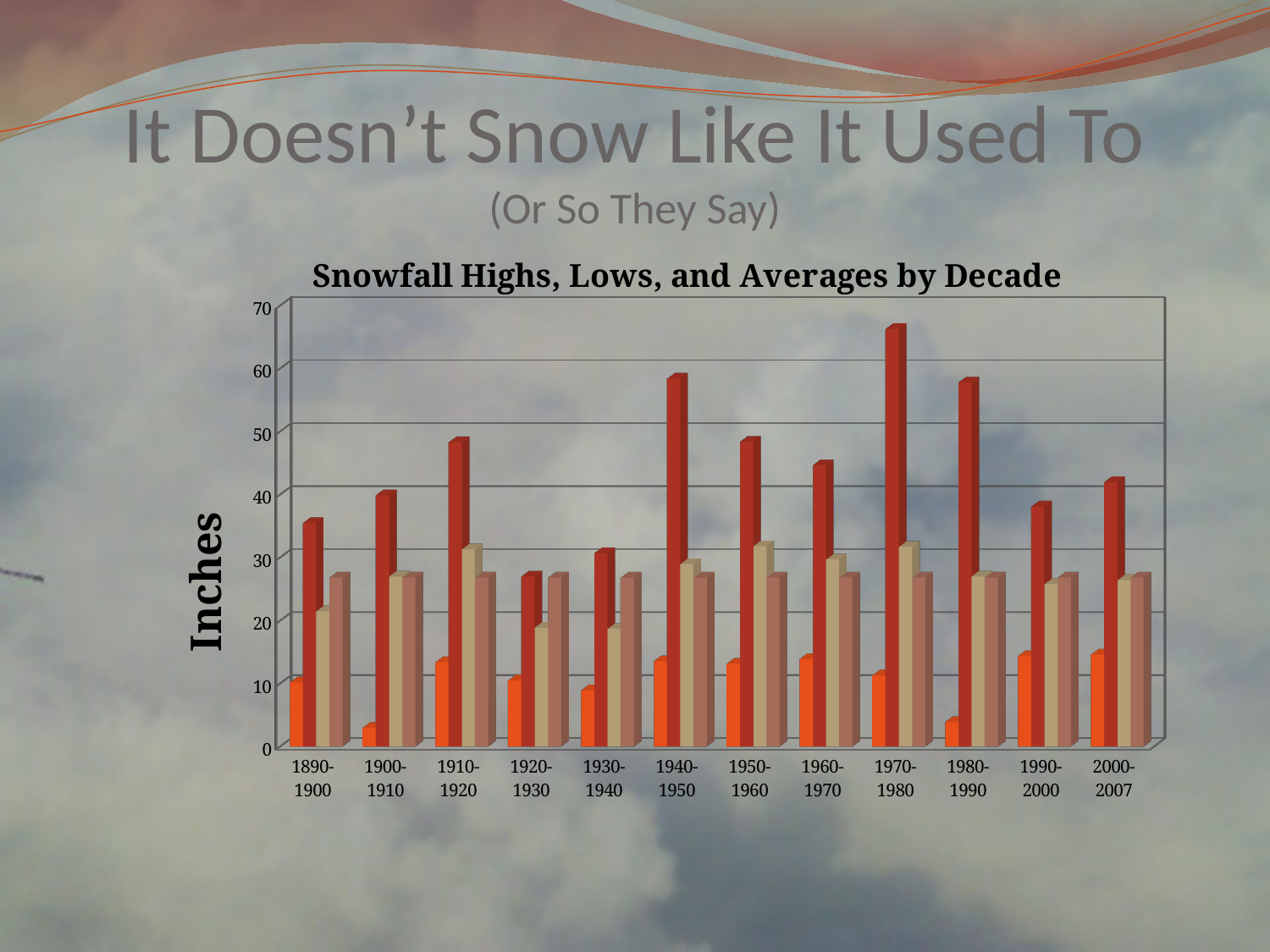
Which decade has the tallest dark red bar? 1970-1980 What is the label on the vertical axis of the chart? Inches What type of chart is shown on the slide? Bar chart How many decade categories are shown along the x axis? 12 Which decade has the taller dark red bar, 1940-1950 or 1950-1960? 1940-1950 Is the dark red bar for 1980-1990 greater or less than 50? greater What is the title of the chart? Snowfall Highs, Lows, and Averages by Decade Which decade has the shortest dark red bar? 1920-1930 Is the orange bar for 1900-1910 greater or less than 10? less Is the dark red bar for 1970-1980 greater or less than 60? greater